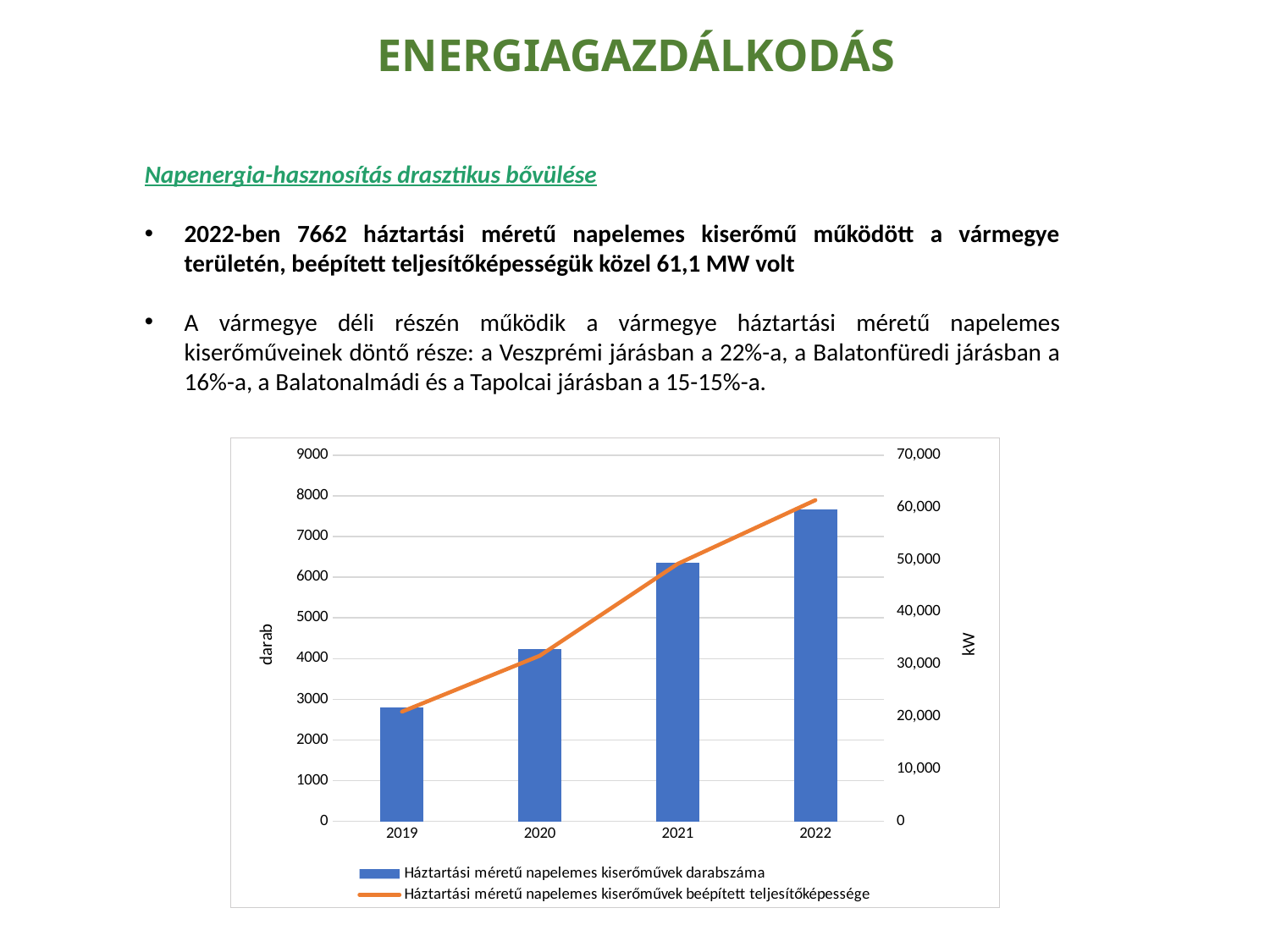
Which year has the lowest bar for the number of household-sized solar power plants (darabszáma)? 2019 Is the installed capacity (beépített teljesítőképessége) line value for 2022 greater or less than 60,000 kW? greater Is the bar value for 2022 greater or less than 7000 darab? greater What kind of chart is shown on the slide? A combined bar and line chart Which year has the highest bar for the number of household-sized solar power plants (darabszáma)? 2022 What unit is shown on the right-hand vertical axis of the chart? kW Is the bar value for 2021 greater or less than 6000 darab? greater Do the bar values rise or fall from 2019 to 2022? rise How many series does the chart legend list? 2 How many years are shown on the x axis of the chart? 4